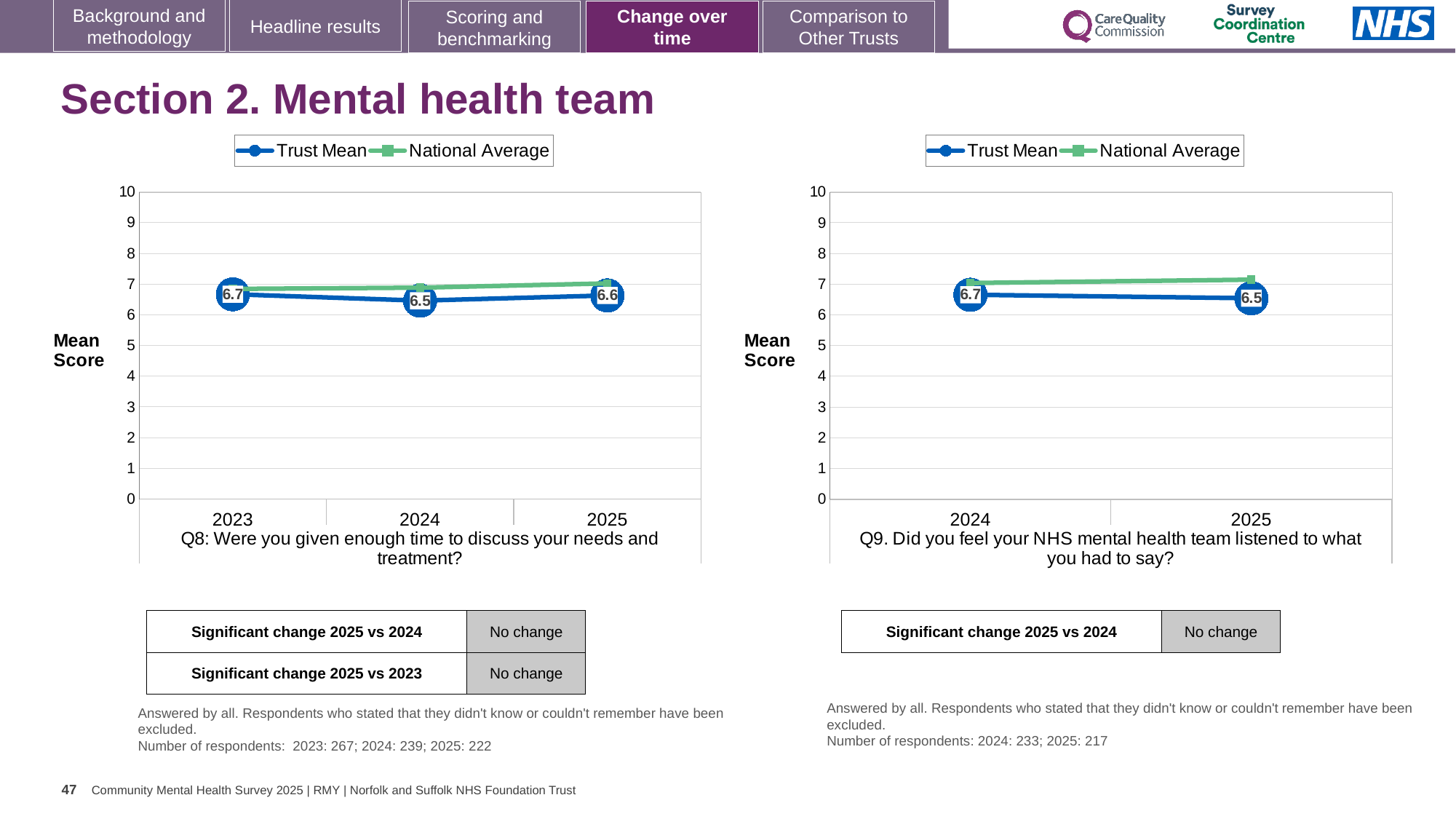
In the Q8 chart, what is the Trust Mean for 2023? 6.7 In the Q9 chart, what is the difference between the Trust Mean for 2024 and 2025? 0.2 In the Q9 chart, what is the Trust Mean for 2025? 6.5 How many years are plotted on the Q8 chart? 3 In the Q8 chart, which year has the lowest Trust Mean? 2024 In the Q8 chart, is the Trust Mean higher in 2023 or in 2024? 2023 In the Q9 chart, what is the Trust Mean for 2024? 6.7 In the Q8 chart, what is the Trust Mean for 2025? 6.6 How many series does the legend of the Q9 chart list? 2 In the Q9 chart, is the National Average for 2025 greater or less than 8? less In the Q8 chart, what is the Trust Mean for 2024? 6.5 What type of chart is used for Q9? Line chart